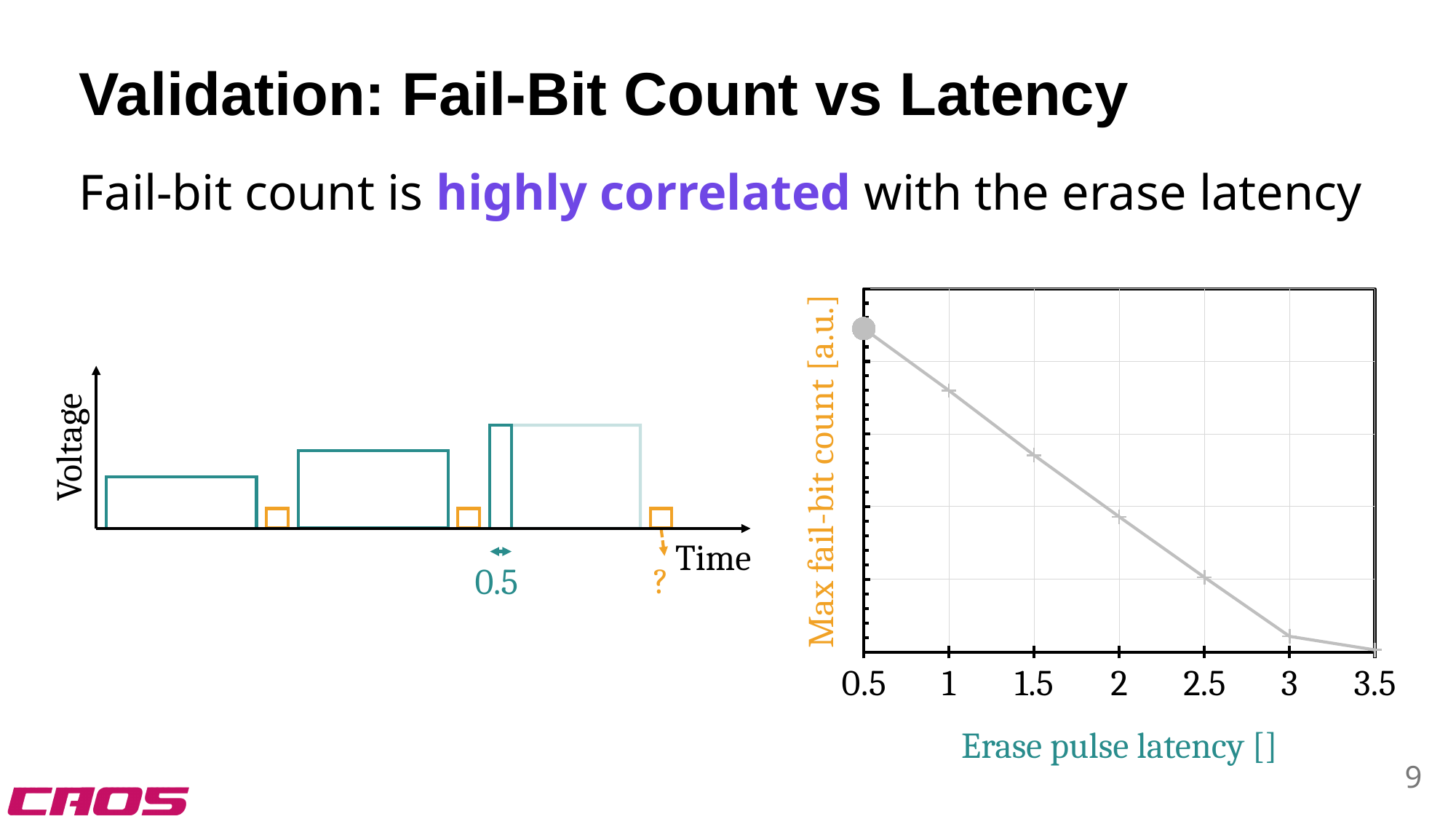
In the chart on the right, does the max fail-bit count rise or fall as erase pulse latency increases? fall In the chart on the right, at which erase pulse latency is the max fail-bit count highest? 0.5 In the chart on the right, which has a higher max fail-bit count: erase pulse latency 2 or 2.5? 2 What is the y-axis label of the chart on the right? Max fail-bit count [a.u.] What is the x-axis label of the chart on the right? Erase pulse latency [] In the chart on the right, at which erase pulse latency is the max fail-bit count lowest? 3.5 How many data points are plotted in the chart on the right? 7 What kind of chart is shown on the right side of the slide? line chart In the chart on the right, which has a lower max fail-bit count: erase pulse latency 1.5 or 3.5? 3.5 In the chart on the right, which has a higher max fail-bit count: erase pulse latency 1 or 3? 1